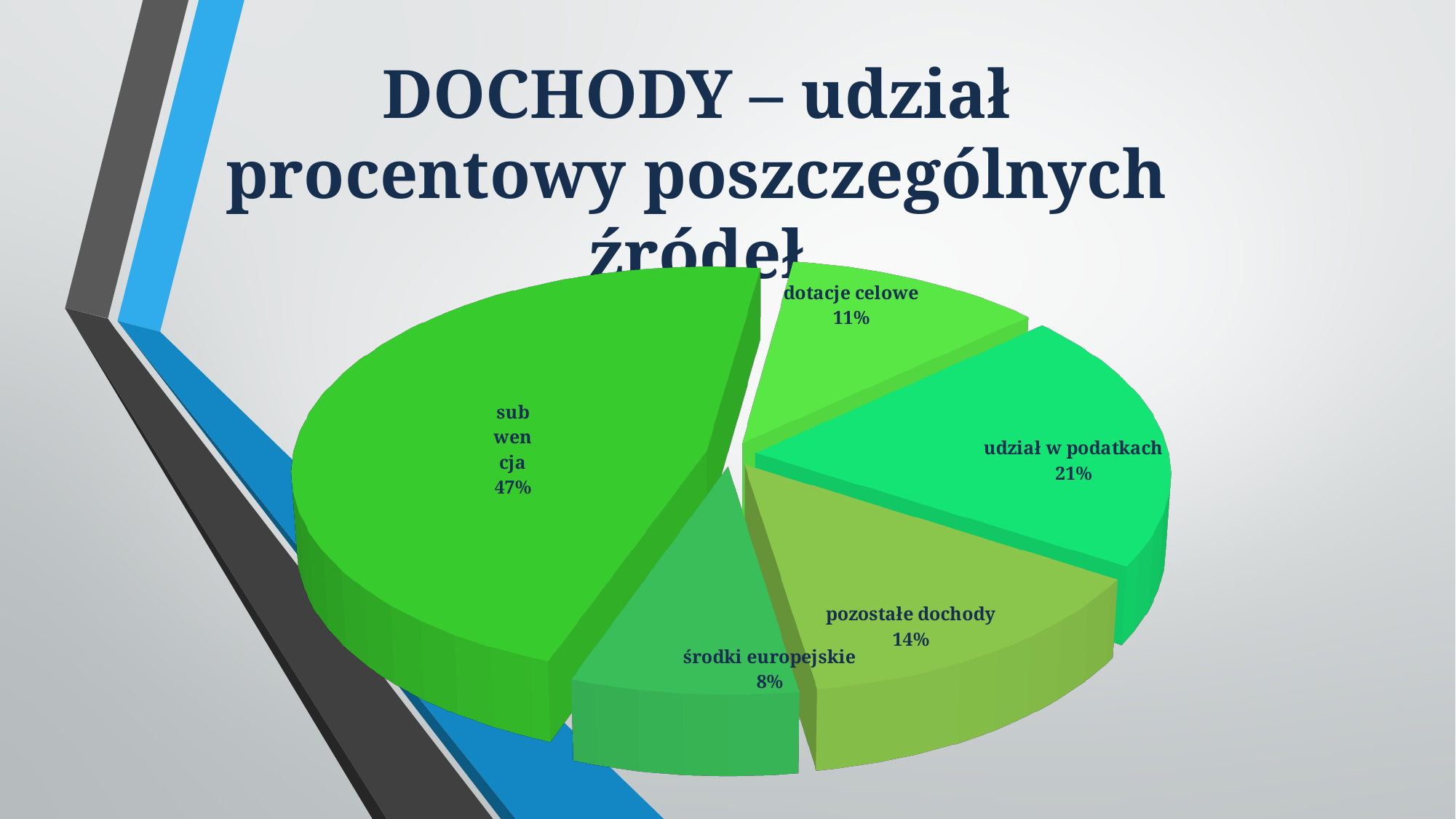
What is the value shown for "dotacje celowe"? 11% Which category has the largest slice of the pie? subwencja Which is larger, "pozostałe dochody" or "środki europejskie"? pozostałe dochody Which category has the smallest slice of the pie? środki europejskie How many slices does the pie chart have? 5 What is the value shown for "środki europejskie"? 8% What share of the pie does "subwencja" have? 47% What kind of chart is shown on the slide? pie chart What is the value shown for "pozostałe dochody"? 14% What is the title of the slide containing the chart? DOCHODY – udział procentowy poszczególnych źródeł What share of the pie does "udział w podatkach" have? 21% What is the difference between the shares of "udział w podatkach" and "dotacje celowe"? 10%